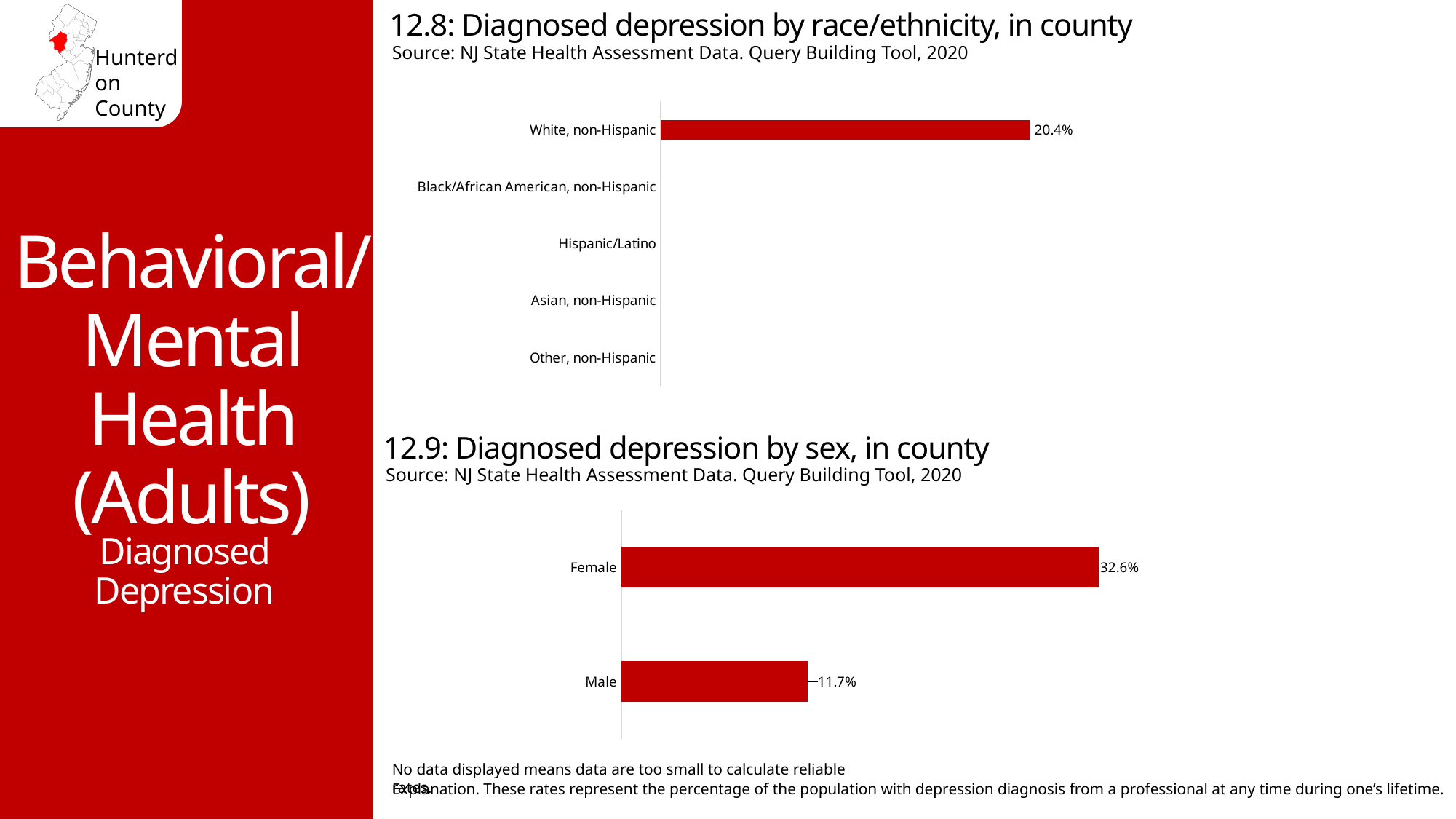
In chart 12.8 (Diagnosed depression by race/ethnicity), which category is the only one with a bar displayed? White, non-Hispanic In chart 12.9 (Diagnosed depression by sex), what is the value for Male? 11.7% In chart 12.9 (Diagnosed depression by sex), what is the difference between the Female and Male values? 20.9% In chart 12.9 (Diagnosed depression by sex), which category has the lowest value? Male In chart 12.8 (Diagnosed depression by race/ethnicity), how many race/ethnicity categories are listed on the axis? 5 In chart 12.9 (Diagnosed depression by sex), what is the value for Female? 32.6% In chart 12.9 (Diagnosed depression by sex), is the value for Female larger or smaller than the value for Male? Larger What is the source cited for chart 12.9 (Diagnosed depression by sex)? NJ State Health Assessment Data. Query Building Tool, 2020 In chart 12.9 (Diagnosed depression by sex), how many categories are shown? 2 In chart 12.8 (Diagnosed depression by race/ethnicity), what is the value for White, non-Hispanic? 20.4% In chart 12.9 (Diagnosed depression by sex), which category has the highest value? Female What kind of chart is chart 12.8 (Diagnosed depression by race/ethnicity)? Bar chart